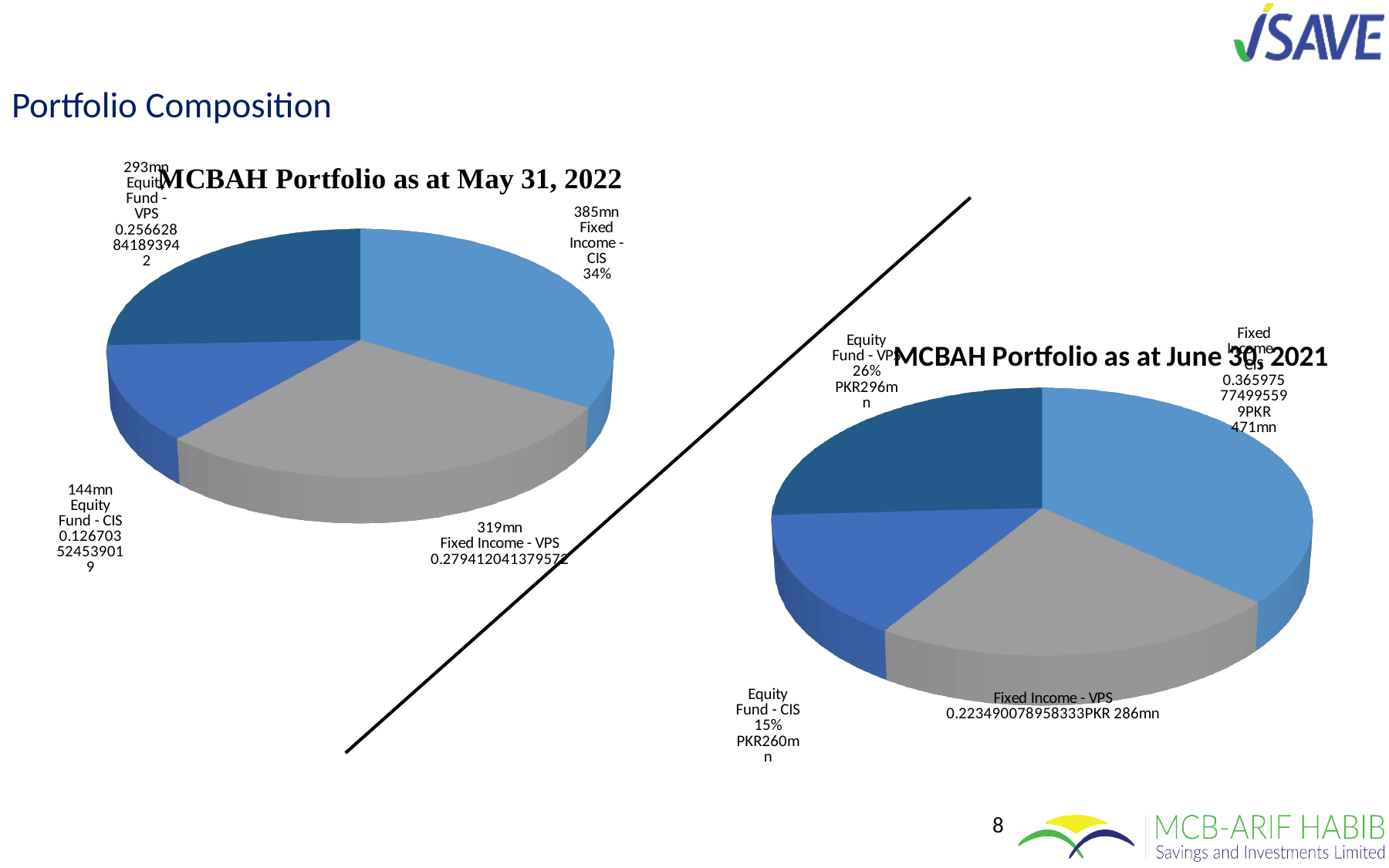
In the MCBAH Portfolio as at May 31, 2022 chart, which category has the smallest slice? Equity Fund - CIS In the MCBAH Portfolio as at June 30, 2021 chart, which is larger, Equity Fund - VPS or Fixed Income - VPS? Equity Fund - VPS In the MCBAH Portfolio as at May 31, 2022 chart, what is the value for Equity Fund - CIS? 144mn In the MCBAH Portfolio as at June 30, 2021 chart, what percentage share does Equity Fund - CIS have? 15% In the MCBAH Portfolio as at June 30, 2021 chart, what is the value for Fixed Income - CIS? PKR 471mn In the MCBAH Portfolio as at May 31, 2022 chart, which category has the largest slice? Fixed Income - CIS In the MCBAH Portfolio as at May 31, 2022 chart, what percentage share does Fixed Income - CIS have? 34% In the MCBAH Portfolio as at May 31, 2022 chart, what is the value for Fixed Income - CIS? 385mn In the MCBAH Portfolio as at May 31, 2022 chart, what is the difference between Fixed Income - CIS and Equity Fund - CIS? 241mn What type of chart is the MCBAH Portfolio as at May 31, 2022 chart? Pie chart In the MCBAH Portfolio as at May 31, 2022 chart, what is the value for Fixed Income - VPS? 319mn How many slices does the MCBAH Portfolio as at June 30, 2021 chart have? 4